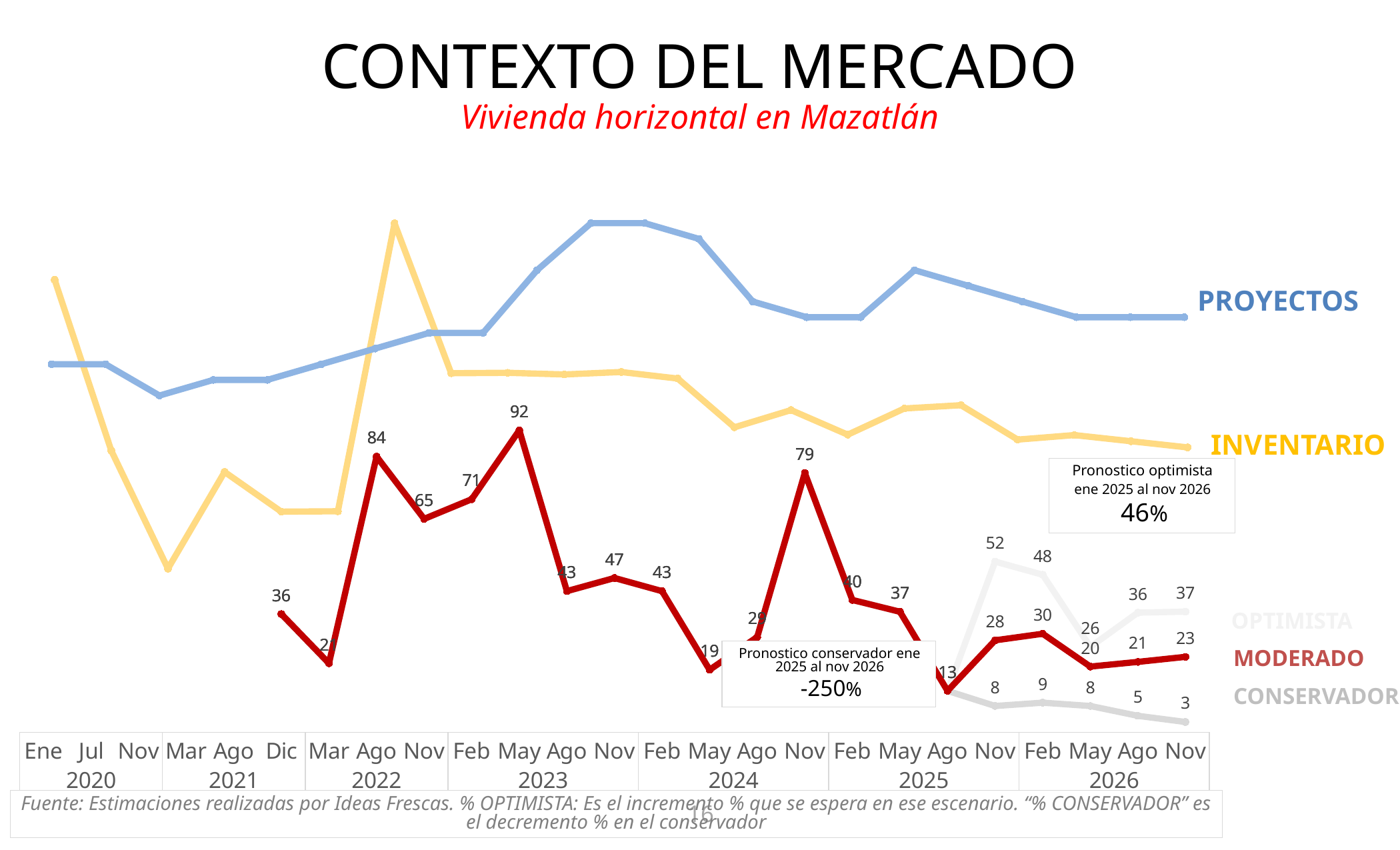
What kind of chart is shown on the slide? line chart At the end of the chart (Nov 2026), which line is higher: PROYECTOS or INVENTARIO? PROYECTOS At Nov 2026, which is larger: the OPTIMISTA value or the MODERADO value? OPTIMISTA What is the difference between the two highest labelled values on the MODERADO line, 92 and 84? 8 What is the value of the OPTIMISTA line at Nov 2026? 37 What is the value of the CONSERVADOR line at Nov 2026? 3 What is the highest labelled value on the OPTIMISTA line? 52 What percentage is given for the 'Pronostico optimista ene 2025 al nov 2026'? 46% What percentage is given for the 'Pronostico conservador ene 2025 al nov 2026'? -250% What is the lowest labelled value on the CONSERVADOR line? 3 What is the value of the MODERADO line at Nov 2026? 23 What is the highest labelled value on the MODERADO line? 92